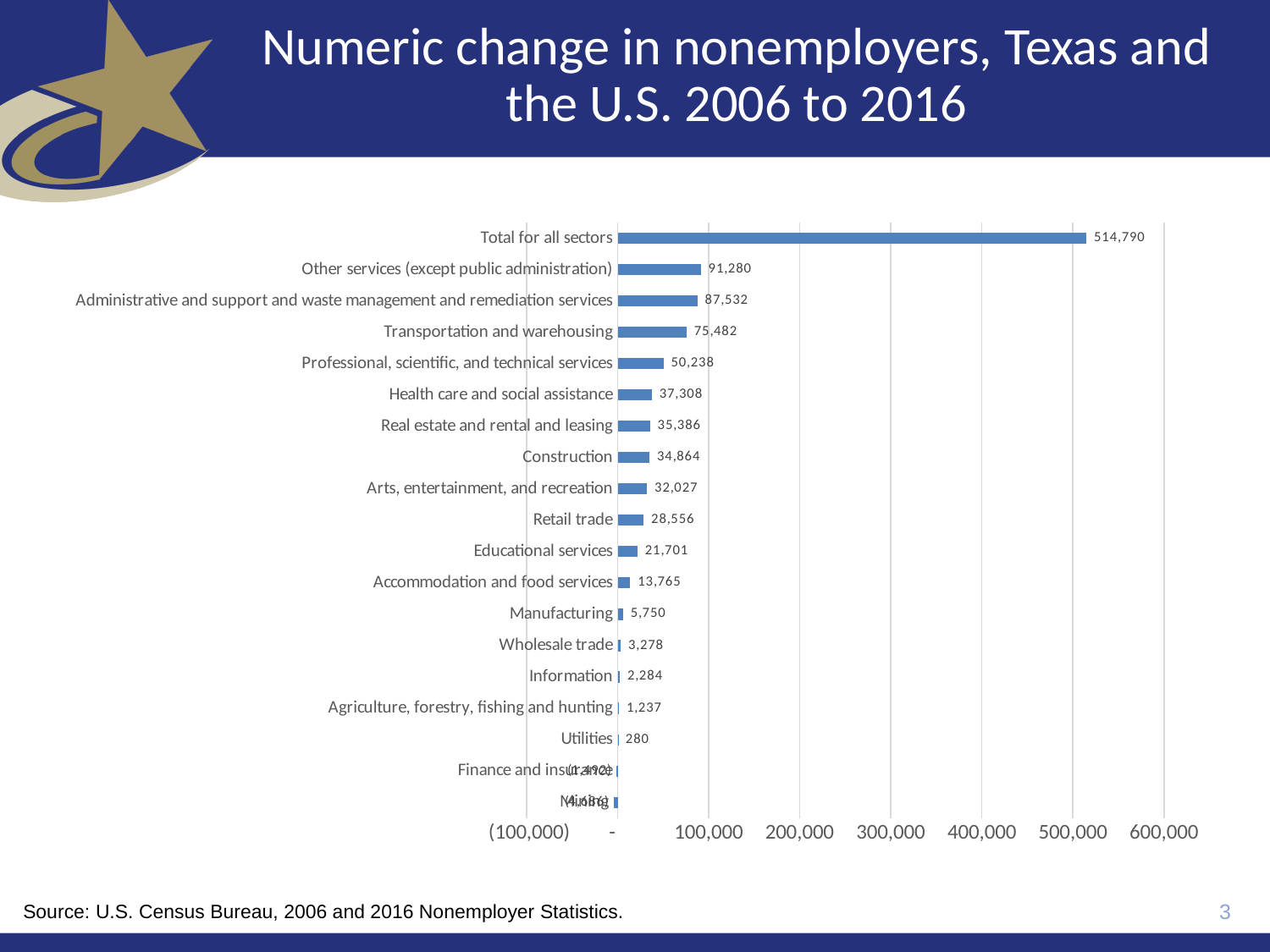
Which is larger, the value for Construction or the value for Real estate and rental and leasing? Real estate and rental and leasing Which category has the highest value in the chart? Total for all sectors What kind of chart is shown on the slide? bar chart What is the difference between the values for Health care and social assistance and Educational services? 15,607 What is the value for Total for all sectors? 514,790 What is the value for Transportation and warehousing? 75,482 Excluding the total, which sector has the largest numeric change? Other services (except public administration) Is the value for Total for all sectors greater or less than 500,000? greater What is the value for Utilities? 280 What is the value for Retail trade? 28,556 What is the difference between the values for Other services (except public administration) and Administrative and support and waste management and remediation services? 3,748 How many categories are shown in the chart? 19